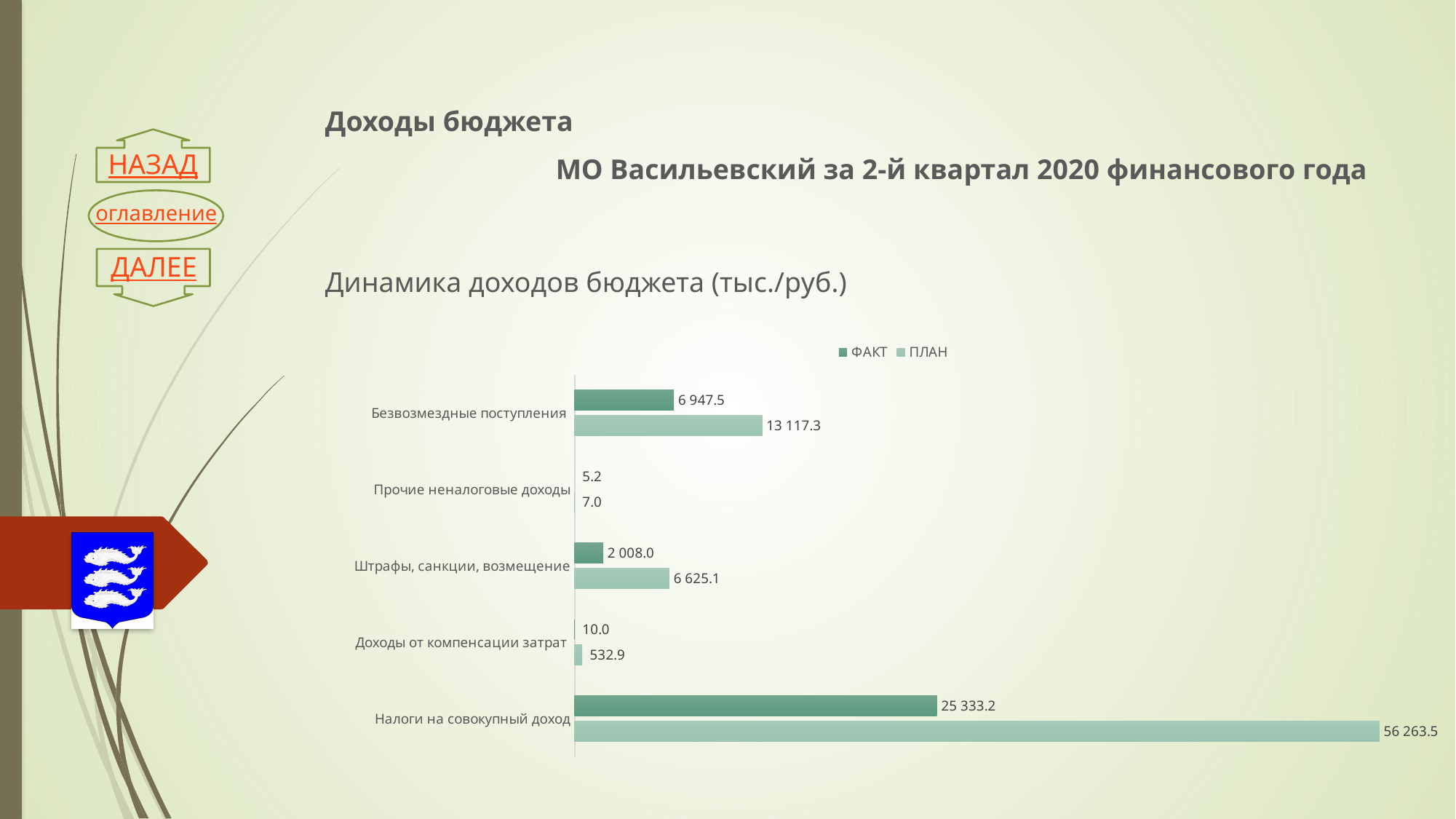
What is the ФАКТ value for Доходы от компенсации затрат? 10.0 Which category has the lowest ПЛАН value? Прочие неналоговые доходы What is the difference between the ПЛАН and ФАКТ values for Безвозмездные поступления? 6 169.8 Which category has the highest ФАКТ value? Налоги на совокупный доход What type of chart is shown on the slide? Bar chart Which is larger for Штрафы, санкции, возмещение: the ФАКТ value or the ПЛАН value? ПЛАН What is the ФАКТ value for Безвозмездные поступления? 6 947.5 What is the difference between the ПЛАН and ФАКТ values for Налоги на совокупный доход? 30 930.3 How many series does the legend list? 2 What is the ПЛАН value for Штрафы, санкции, возмещение? 6 625.1 What is the ПЛАН value for Налоги на совокупный доход? 56 263.5 How many categories are shown in the chart? 5